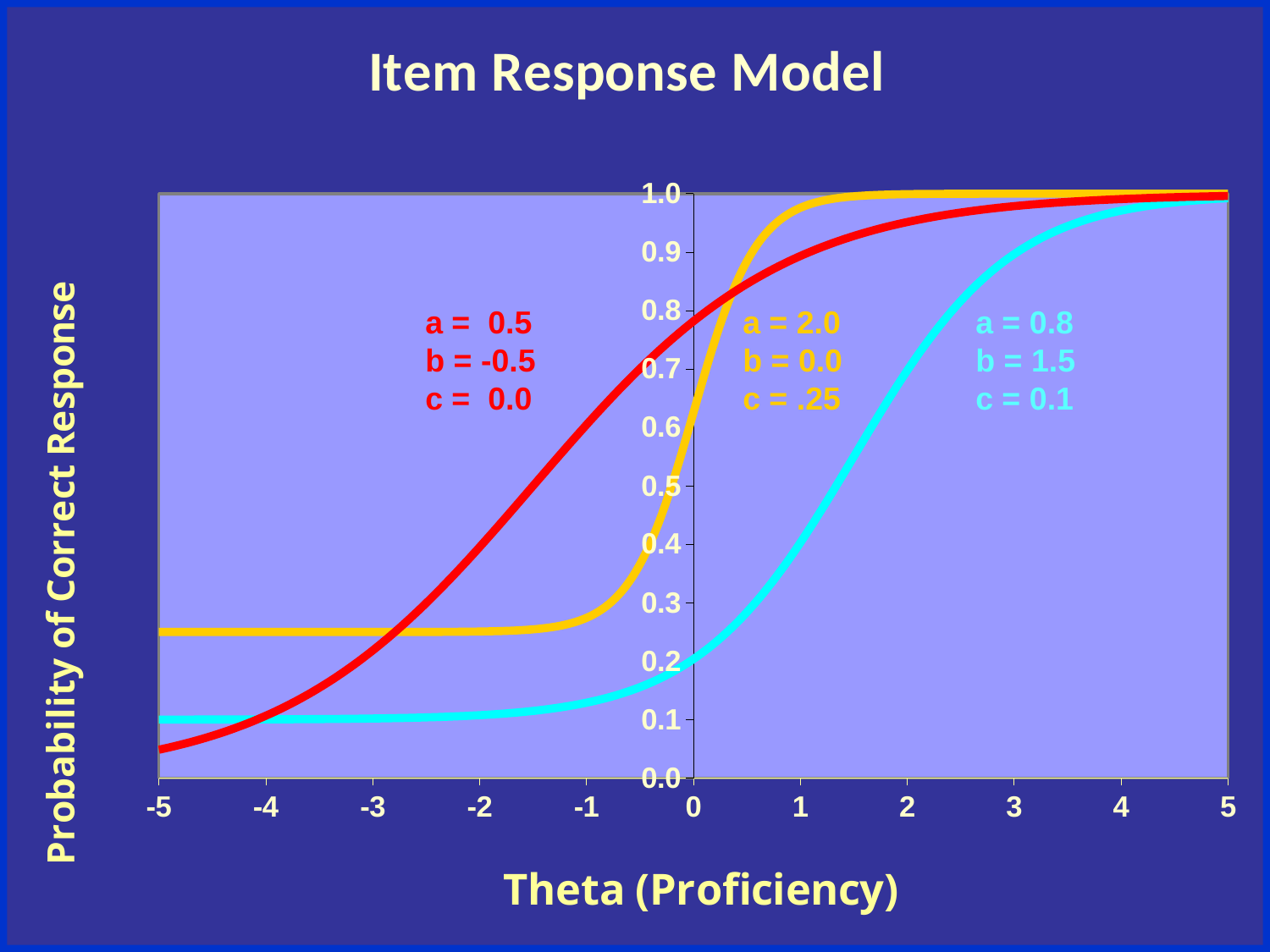
At Theta = 0, is the value of the red curve greater or less than 0.5? greater At Theta = 0, which curve has the highest probability of correct response? the red curve (a = 0.5, b = -0.5, c = 0.0) What is the title of the chart? Item Response Model What kind of chart is shown on the slide? line chart What is the value of the b parameter for the red curve? -0.5 At Theta = 0, which curve has the lowest probability of correct response? the cyan curve (a = 0.8, b = 1.5, c = 0.1) How many curves are plotted on the chart? 3 What is the label of the x axis? Theta (Proficiency) What is the value of the c parameter for the cyan curve? 0.1 At Theta = 0, is the value of the cyan curve greater or less than 0.5? less Do the curves rise or fall as Theta increases from -5 to 5? rise What is the value of the a parameter for the yellow curve? 2.0